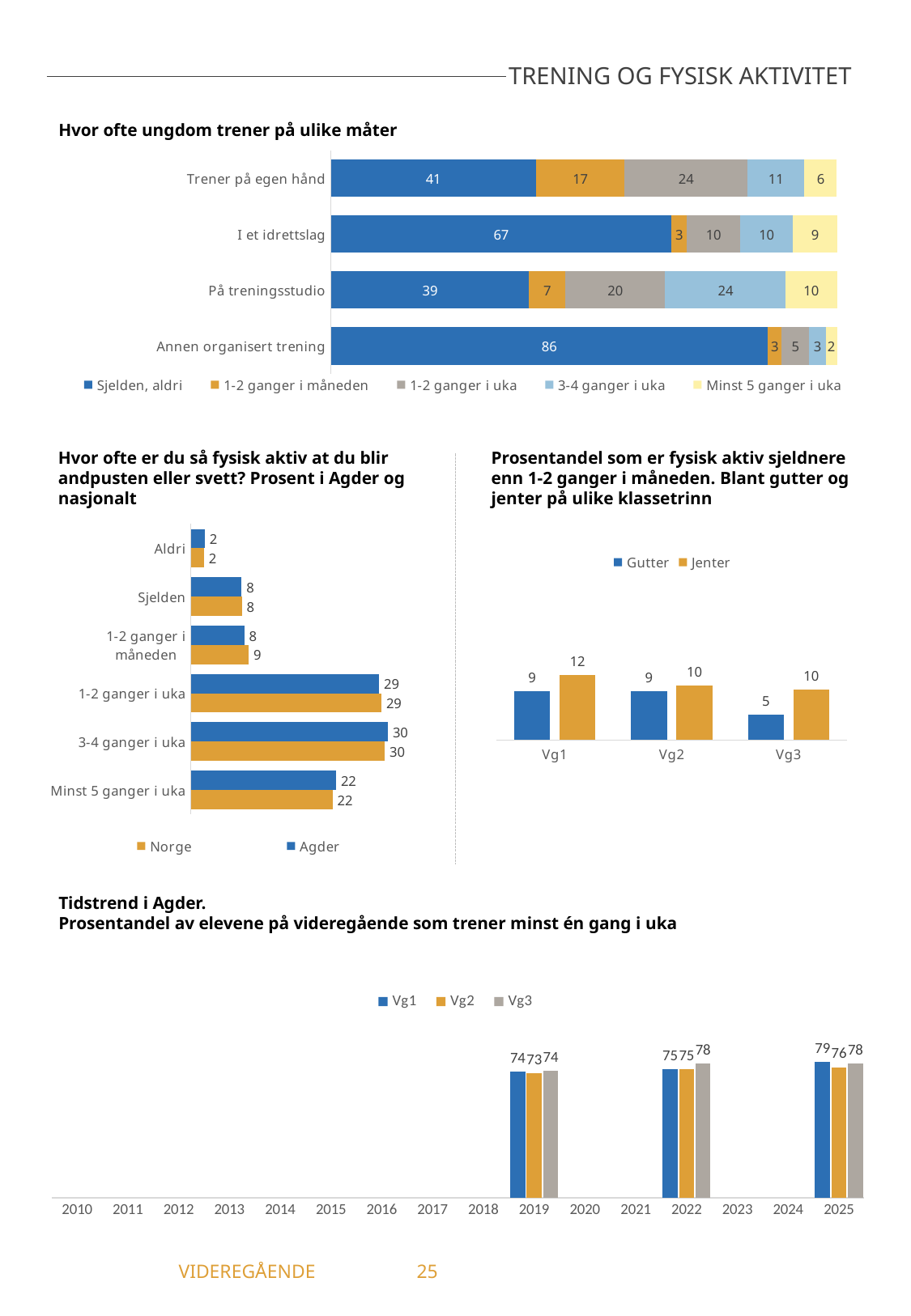
In the chart 'Prosentandel som er fysisk aktiv sjeldnere enn 1-2 ganger i måneden', what is the difference between Jenter and Gutter for Vg3? 5 In the chart 'Hvor ofte ungdom trener på ulike måter', what is the value for '3-4 ganger i uka' for 'På treningsstudio'? 24 In the chart 'Hvor ofte ungdom trener på ulike måter', what is the value for 'Sjelden, aldri' for 'Annen organisert trening'? 86 In the chart 'Tidstrend i Agder', do the values for Vg1 rise or fall from 2019 to 2025? rise In the chart 'Tidstrend i Agder', what is the value for Vg1 in 2025? 79 How many series does the legend list in the chart 'Hvor ofte ungdom trener på ulike måter'? 5 In the chart 'Hvor ofte er du så fysisk aktiv at du blir andpusten eller svett?', which category has the highest value for Agder? 3-4 ganger i uka In the chart 'Hvor ofte er du så fysisk aktiv at du blir andpusten eller svett?', what is the value for Norge for '1-2 ganger i måneden'? 9 In the chart 'Hvor ofte ungdom trener på ulike måter', what is the total of the stacked bar for 'Trener på egen hånd'? 99 In the chart 'Hvor ofte ungdom trener på ulike måter', which category has the highest value for 'Sjelden, aldri'? Annen organisert trening In the chart 'Prosentandel som er fysisk aktiv sjeldnere enn 1-2 ganger i måneden', which is larger for Vg1, Gutter or Jenter? Jenter How many categories are shown in the chart 'Hvor ofte er du så fysisk aktiv at du blir andpusten eller svett?'? 6